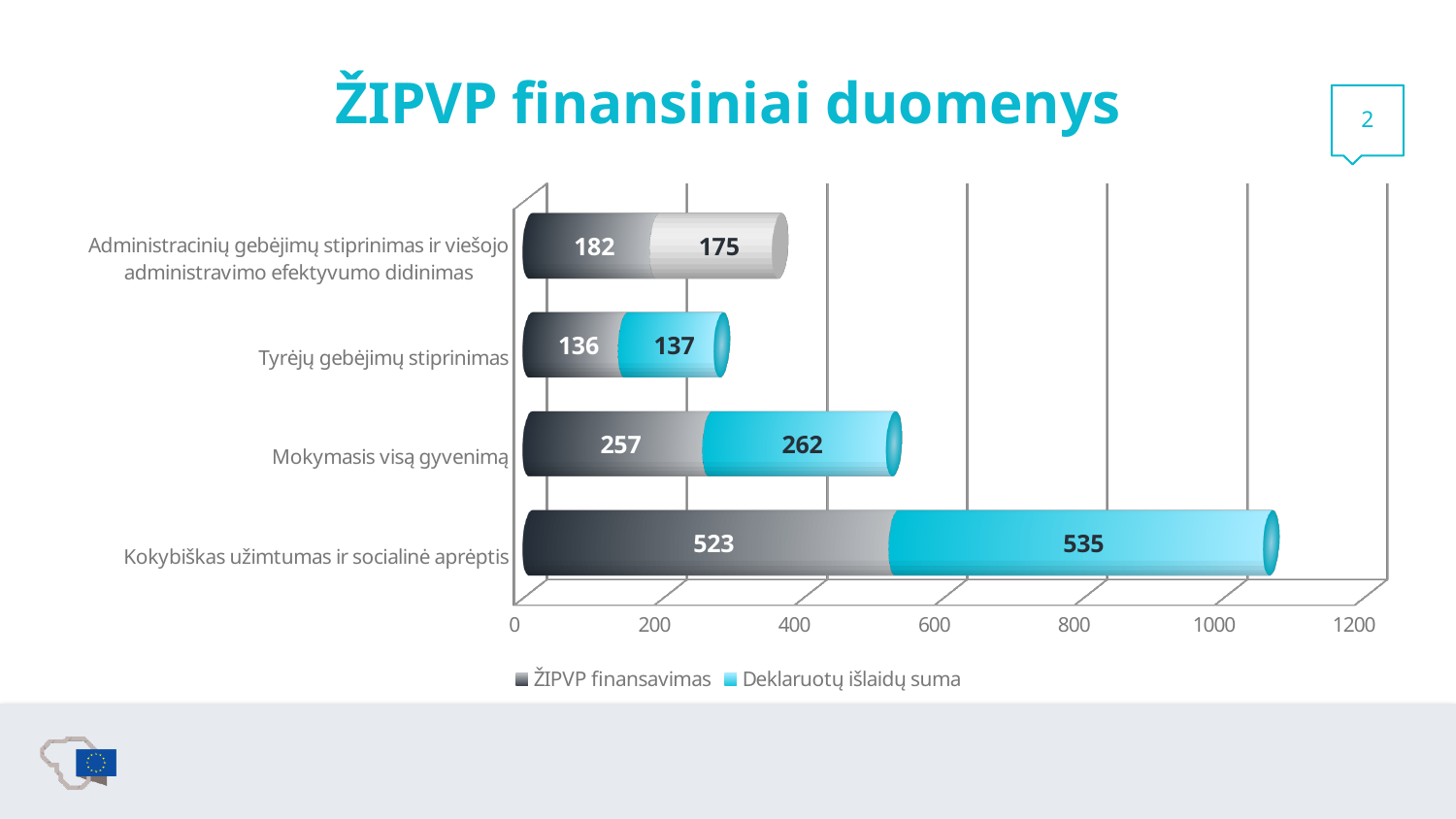
What is the total of the stacked bar for Tyrėjų gebėjimų stiprinimas? 273 What is the Deklaruotų išlaidų suma value for Mokymasis visą gyvenimą? 262 Which category has the highest ŽIPVP finansavimas value? Kokybiškas užimtumas ir socialinė aprėptis Which is larger for Mokymasis visą gyvenimą: ŽIPVP finansavimas or Deklaruotų išlaidų suma? Deklaruotų išlaidų suma What is the Deklaruotų išlaidų suma value for Administracinių gebėjimų stiprinimas ir viešojo administravimo efektyvumo didinimas? 175 What is the total of the stacked bar for Kokybiškas užimtumas ir socialinė aprėptis? 1058 How many series does the legend list? 2 What is the ŽIPVP finansavimas value for Kokybiškas užimtumas ir socialinė aprėptis? 523 How many categories are shown in the chart? 4 What is the difference between the Deklaruotų išlaidų suma and ŽIPVP finansavimas values for Kokybiškas užimtumas ir socialinė aprėptis? 12 Which category has the lowest Deklaruotų išlaidų suma value? Tyrėjų gebėjimų stiprinimas What type of chart is shown on the slide? Stacked bar chart